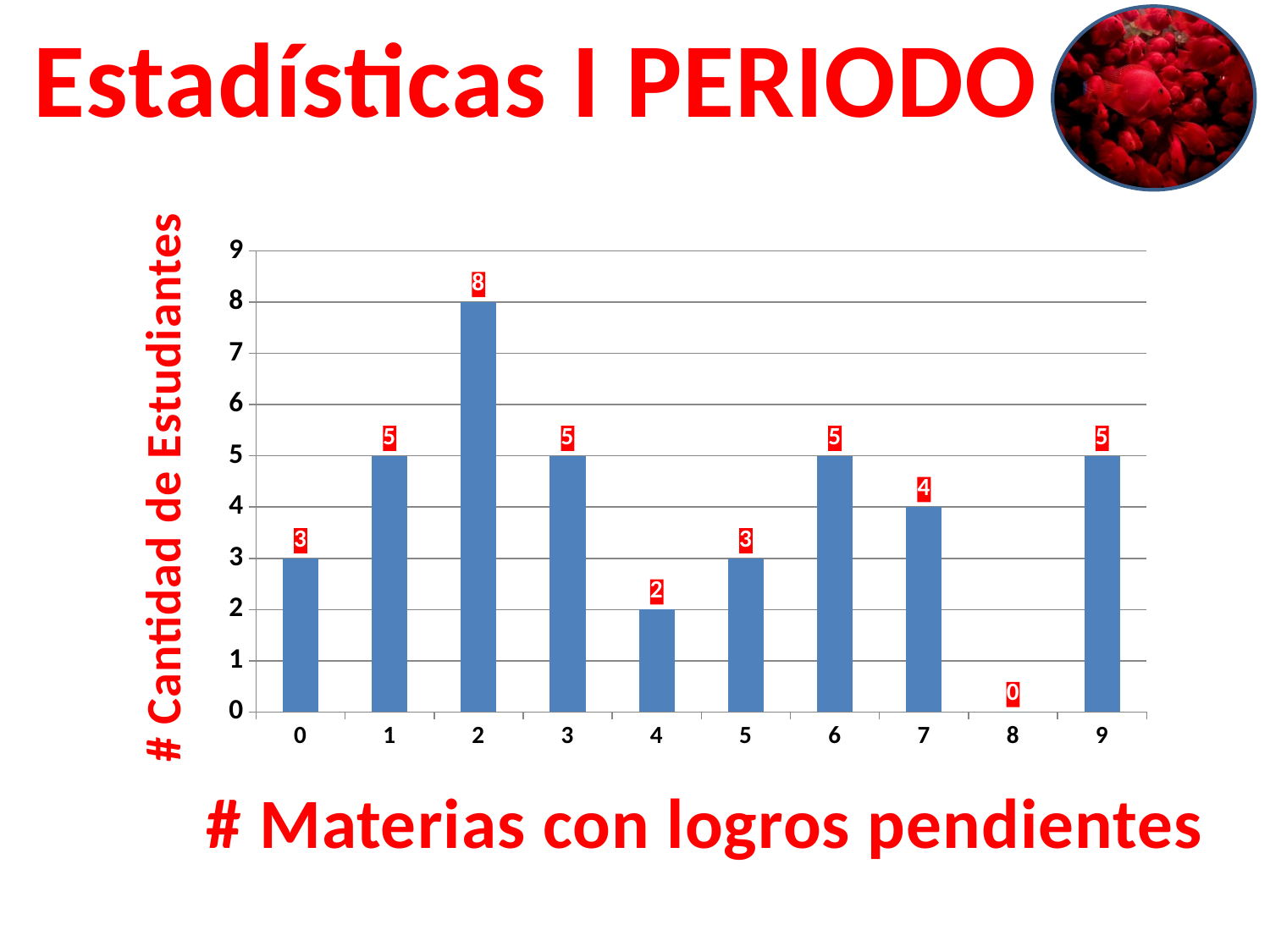
What is the label of the horizontal axis? # Materias con logros pendientes What is the value for category 8 on the x axis? 0 What is the label of the vertical axis? # Cantidad de Estudiantes What is the value for category 7 on the x axis? 4 How many categories have a value of 5? 4 What is the difference between the value for category 2 and the value for category 4? 6 What kind of chart is shown on the slide? bar chart How many categories are shown on the x axis? 10 Which category on the x axis has the highest number of students? 2 Which category on the x axis has the lowest number of students? 8 Which is larger: the value for category 0 or the value for category 7? category 7 How many students have 2 subjects with pending achievements (# Materias con logros pendientes = 2)? 8